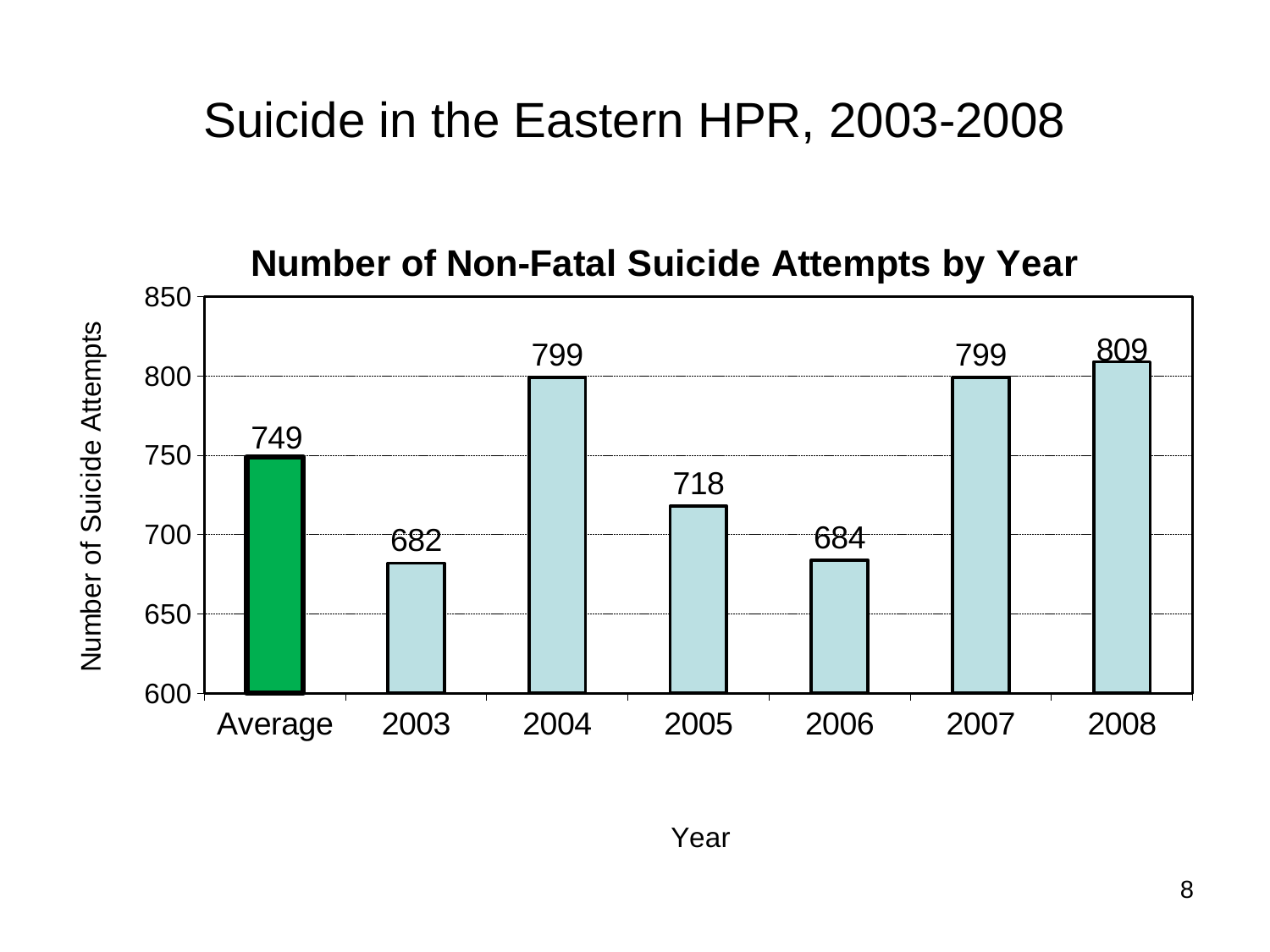
What is the difference between the number of attempts in 2008 and in 2003? 127 What is the value shown for the Average bar? 749 Which year has the highest number of non-fatal suicide attempts? 2008 What is the title of the chart? Number of Non-Fatal Suicide Attempts by Year Is the value for 2007 greater or less than the Average value? greater What type of chart is shown on the slide? bar chart What is the difference between the 2004 value and the 2005 value? 81 What is the number of non-fatal suicide attempts in 2005? 718 What is the number of non-fatal suicide attempts in 2008? 809 Which year has the lowest number of non-fatal suicide attempts? 2003 Which is larger, the value for 2006 or the value for 2003? 2006 How many bars are shown in the chart? 7